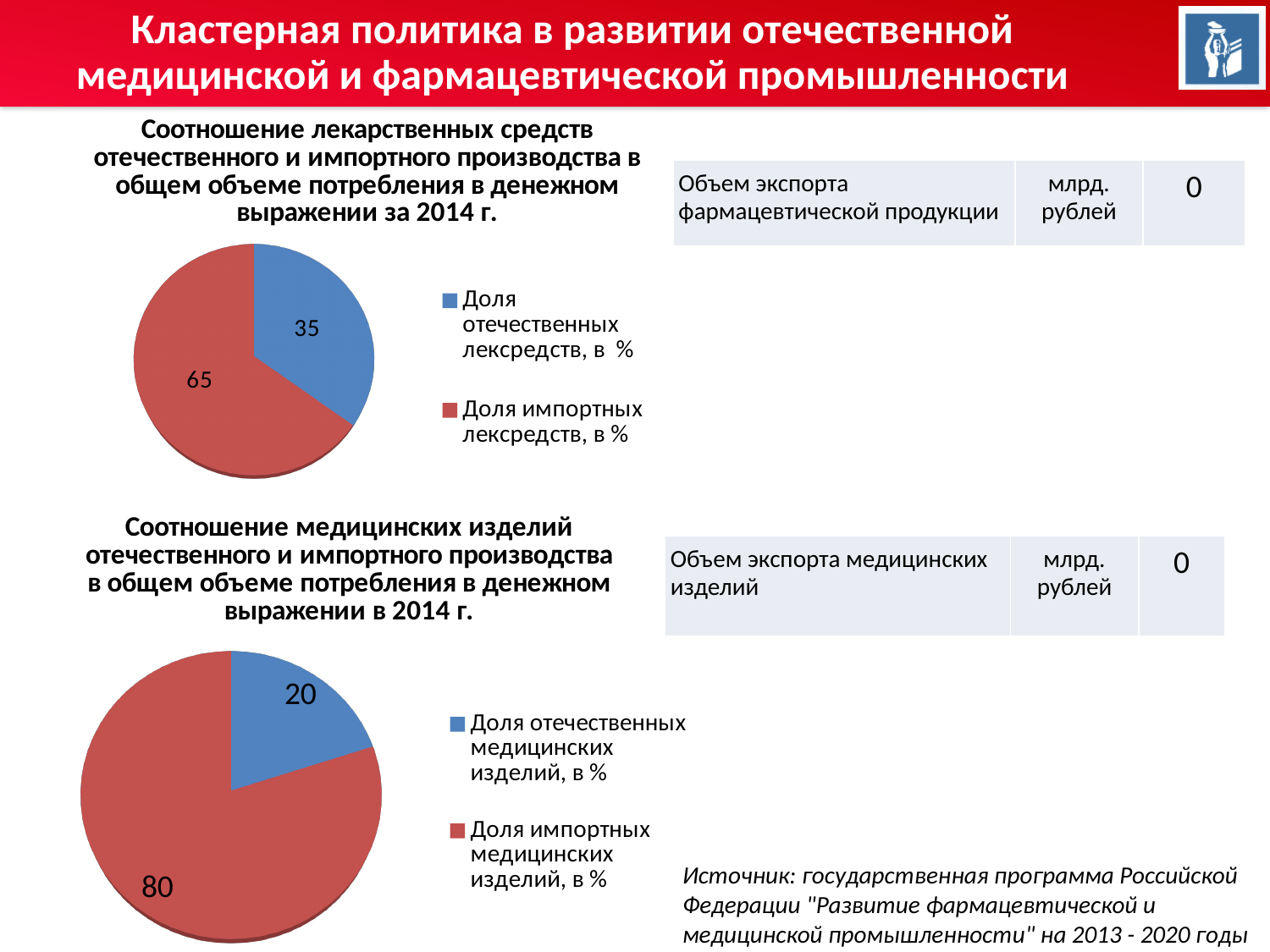
In the bottom pie chart (medical devices, 2014), which slice is the smallest? Доля отечественных медицинских изделий, в % In the top pie chart (drugs, 2014), what is the value for the share of imported drugs (Доля импортных лексредств)? 65 In the top pie chart (drugs, 2014), what colour is the slice for imported drugs? Red Which is larger: the domestic share in the top pie chart (drugs) or the domestic share in the bottom pie chart (medical devices)? Top pie chart (drugs), 35 What type of chart is used for the top chart on the slide? Pie chart In the bottom pie chart (medical devices, 2014), what is the value for the share of imported medical devices? 80 In the bottom pie chart (medical devices, 2014), what is the value for the share of domestic medical devices? 20 In the top pie chart (drugs, 2014), which slice is the largest? Доля импортных лексредств, в % In the top pie chart (drugs, 2014), what is the difference between the imported share and the domestic share? 30 How many slices does the bottom pie chart (medical devices, 2014) have? 2 In the bottom pie chart (medical devices, 2014), what is the difference between the imported share and the domestic share? 60 In the top pie chart (drugs, 2014), what is the value for the share of domestic drugs (Доля отечественных лексредств)? 35